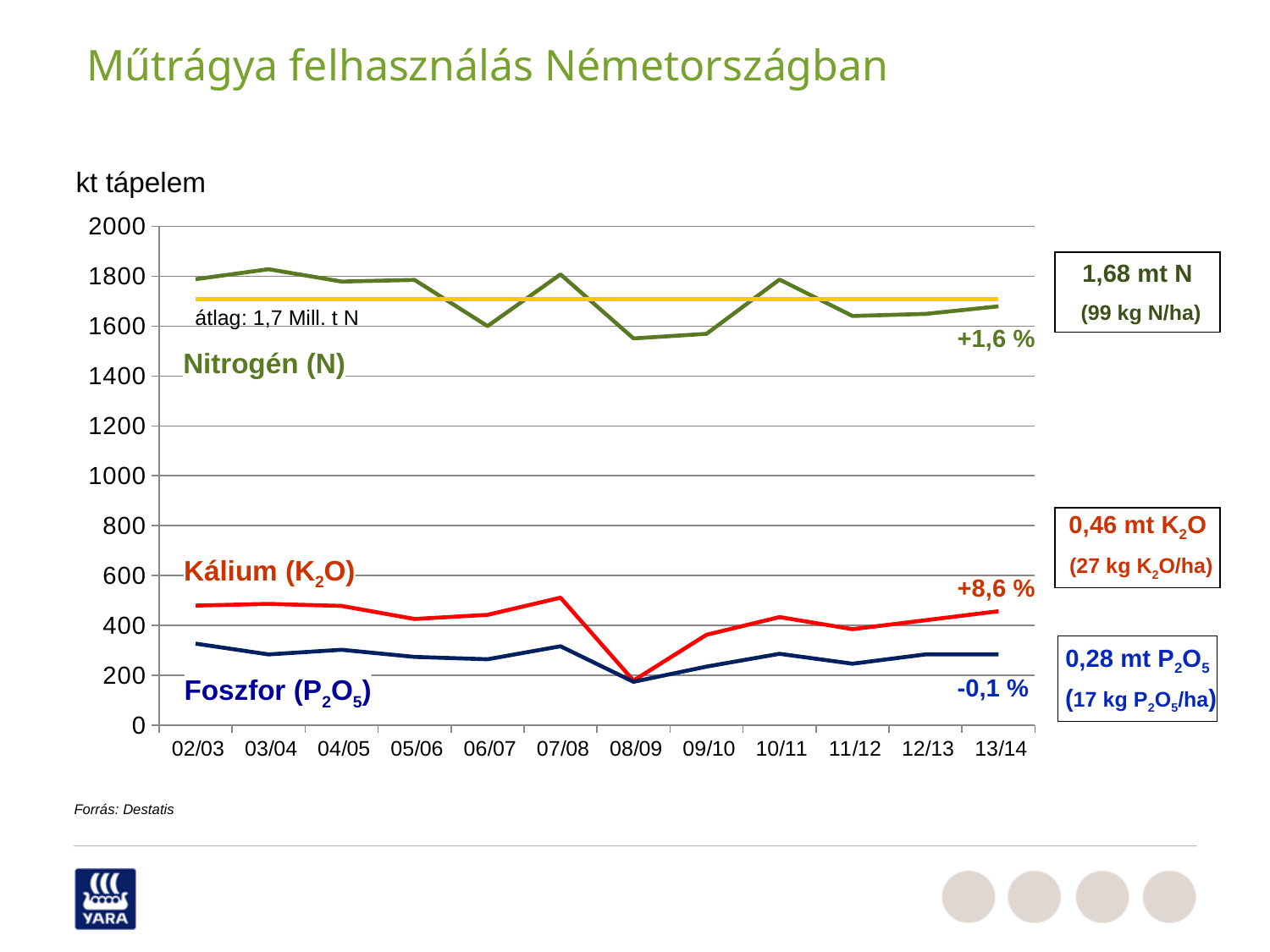
In which period is the Kálium (K2O) value lowest? 08/09 Is the value for Kálium (K2O) in 05/06 greater or less than 600? less What kind of chart is shown on the slide? line chart Does the Kálium (K2O) line rise or fall from 08/09 to 13/14? rise Which is larger in 02/03, the Kálium (K2O) value or the Foszfor (P2O5) value? Kálium (K2O) Is the value for Nitrogén (N) in 08/09 greater or less than 1600? less How many nutrient series are labelled on the chart? 3 Is the value for Nitrogén (N) in 07/08 greater or less than 1600? greater In which period is the Foszfor (P2O5) value lowest? 08/09 How many time periods are shown on the x axis of the chart? 12 What average value is stated for the yellow line on the chart? átlag: 1,7 Mill. t N